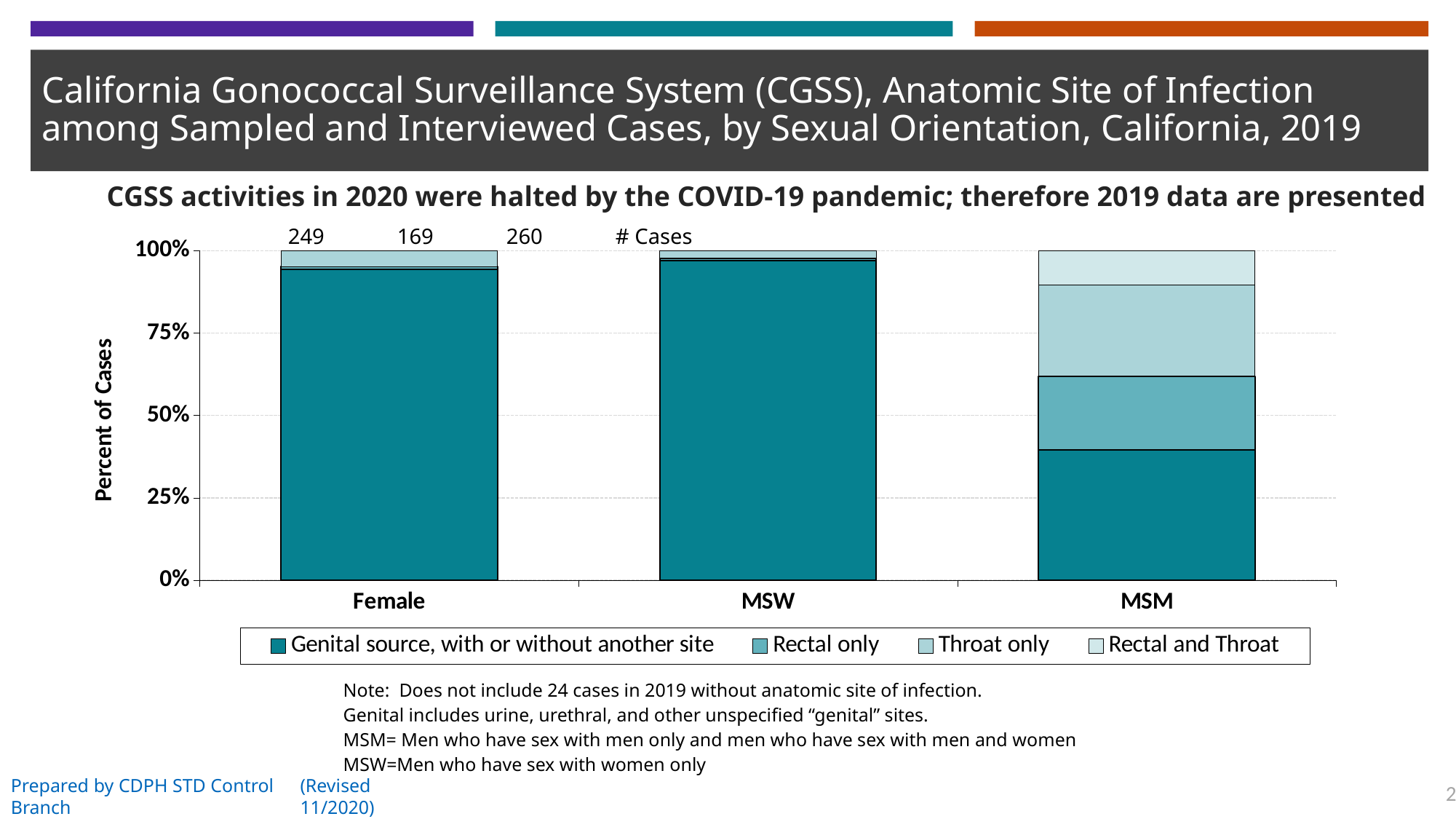
What is the number of cases shown above the Female bar? 249 Which has a larger 'Genital source, with or without another site' share, Female or MSM? Female Which category has the largest 'Throat only' segment? MSM What is the label of the y axis? Percent of Cases What is the first entry in the legend? Genital source, with or without another site How many series does the legend list? 4 What type of chart is shown on the slide? Stacked bar chart How many sexual orientation categories are shown on the x axis? 3 Is the 'Rectal and Throat' share for MSM greater or less than 25%? less Which category has the smallest 'Genital source, with or without another site' share? MSM Is the 'Genital source, with or without another site' share for Female greater or less than 75%? greater Is the 'Genital source, with or without another site' share for MSM greater or less than 50%? less